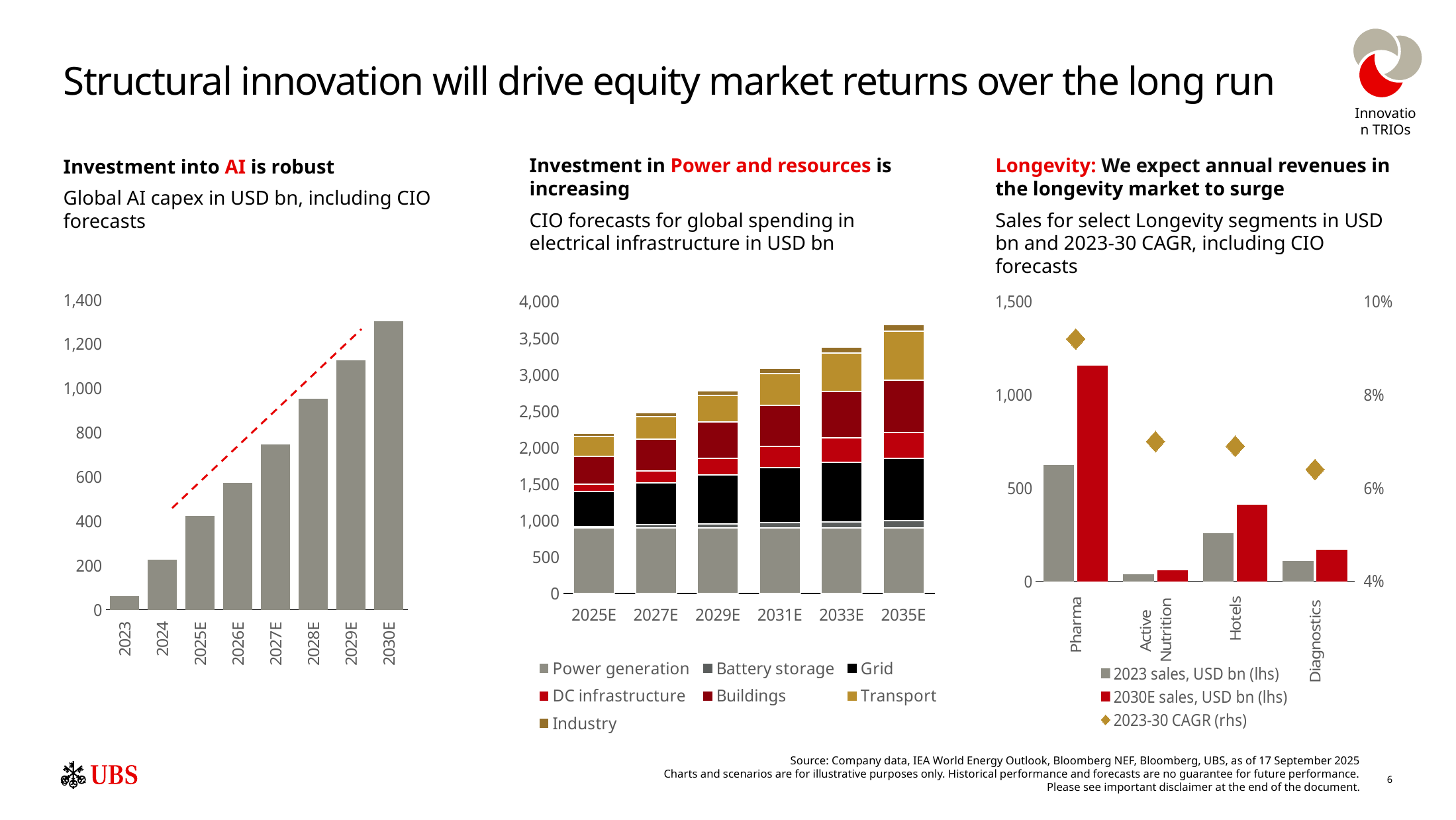
On the middle chart (CIO forecasts for global spending in electrical infrastructure), how many series does the legend list? 7 On the left chart (Global AI capex), is the value for 2030E greater or less than 1,200? greater On the left chart (Global AI capex), is the value for 2027E greater or less than 600? greater On the right chart (Sales for select Longevity segments), which segment has the highest 2023 sales? Pharma On the left chart (Global AI capex), which year has the lowest value? 2023 On the middle chart (CIO forecasts for global spending in electrical infrastructure), what kind of chart is it? stacked bar chart On the right chart (Sales for select Longevity segments), which segment has the lowest 2023-30 CAGR? Diagnostics On the left chart (Global AI capex), do the values rise or fall from 2023 to 2030E? rise On the left chart (Global AI capex), which year has the highest value? 2030E On the left chart (Global AI capex), how many years are shown on the x axis? 8 On the middle chart (CIO forecasts for global spending in electrical infrastructure), is the total stacked value for 2035E greater or less than 3,500? greater